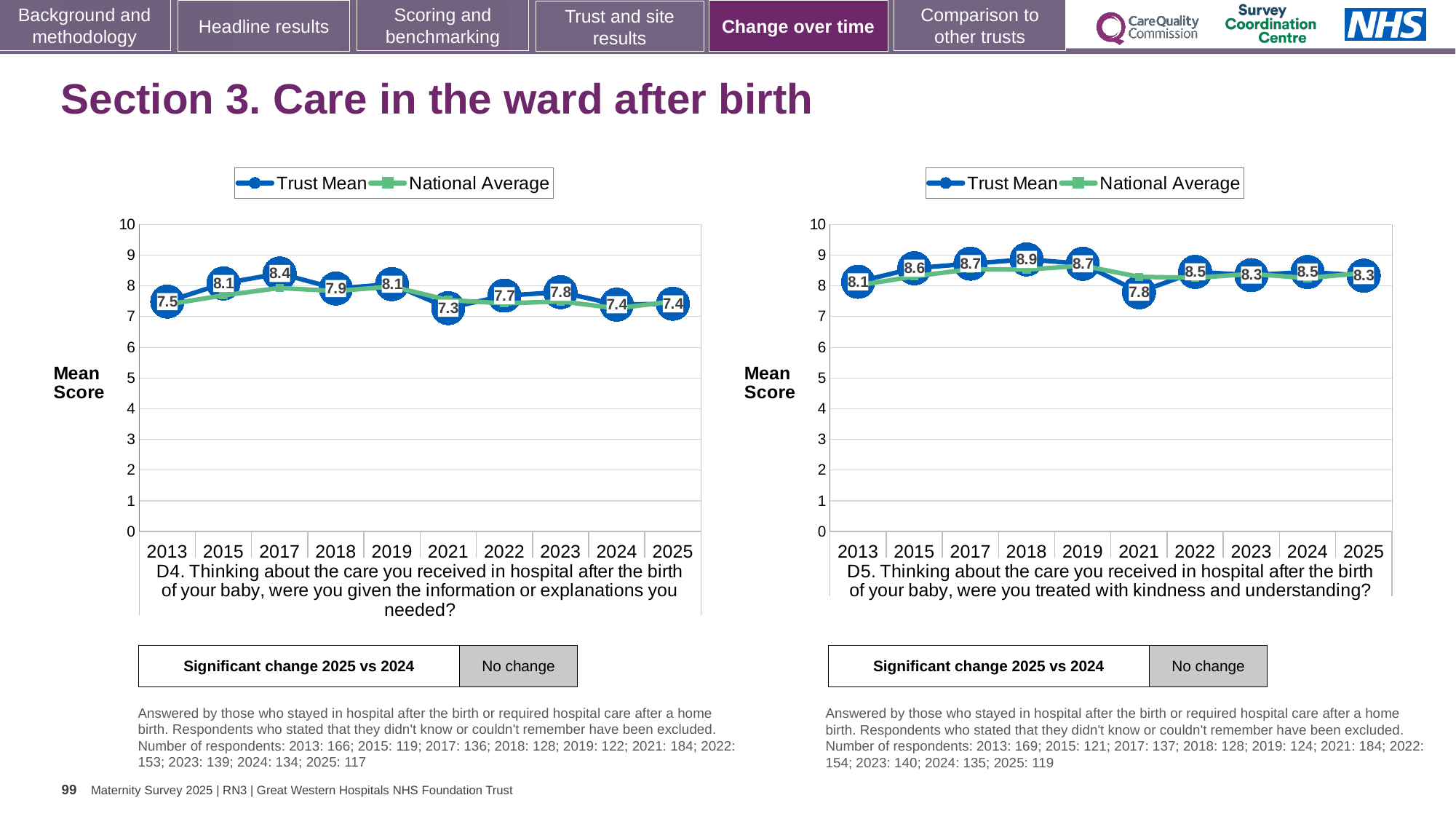
On the left chart (D4), which year has the lowest Trust Mean score? 2021 On the left chart (D4), which year has the highest Trust Mean score? 2017 On the left chart (D4), what is the Trust Mean score for 2025? 7.4 On the right chart (D5), what is the Trust Mean score for 2018? 8.9 On the left chart (D4), is the Trust Mean score for 2015 or 2024 higher? 2015 What kind of chart is the left chart (D4)? Line chart On the right chart (D5), what is the difference between the Trust Mean scores for 2018 and 2021? 1.1 On the left chart (D4), what is the Trust Mean score for 2017? 8.4 On the right chart (D5), which year has the lowest Trust Mean score? 2021 How many series does the legend of the right chart (D5) list? 2 How many years are plotted on the x axis of the left chart (D4)? 10 On the right chart (D5), what is the Trust Mean score for 2021? 7.8